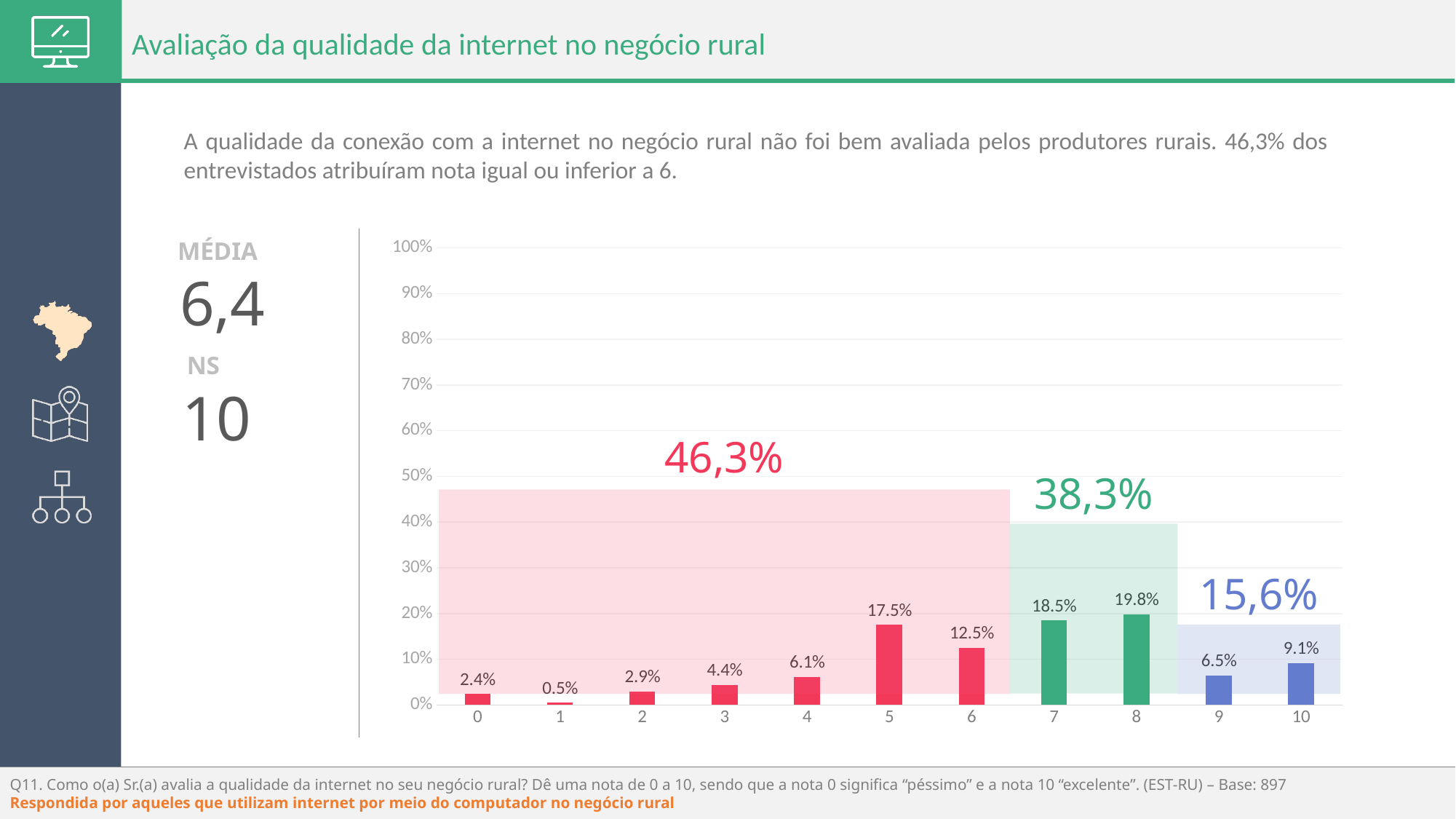
Is the value for score 5 greater or less than 10%? greater What percentage of respondents gave a score of 5? 17.5% Which score has the lowest percentage of respondents? 1 What is the average (MÉDIA) score shown on the slide? 6,4 Which has a larger percentage, score 6 or score 10? Score 6 How many score categories are shown on the x axis? 11 What combined percentage is shown for the green-shaded group of scores 7 and 8? 38,3% What percentage of respondents gave a score of 1? 0.5% What percentage of respondents gave a score of 8? 19.8% Which score has the highest percentage of respondents? 8 What is the difference between the percentages for scores 8 and 7? 1.3% What kind of chart is shown on the slide? Bar chart